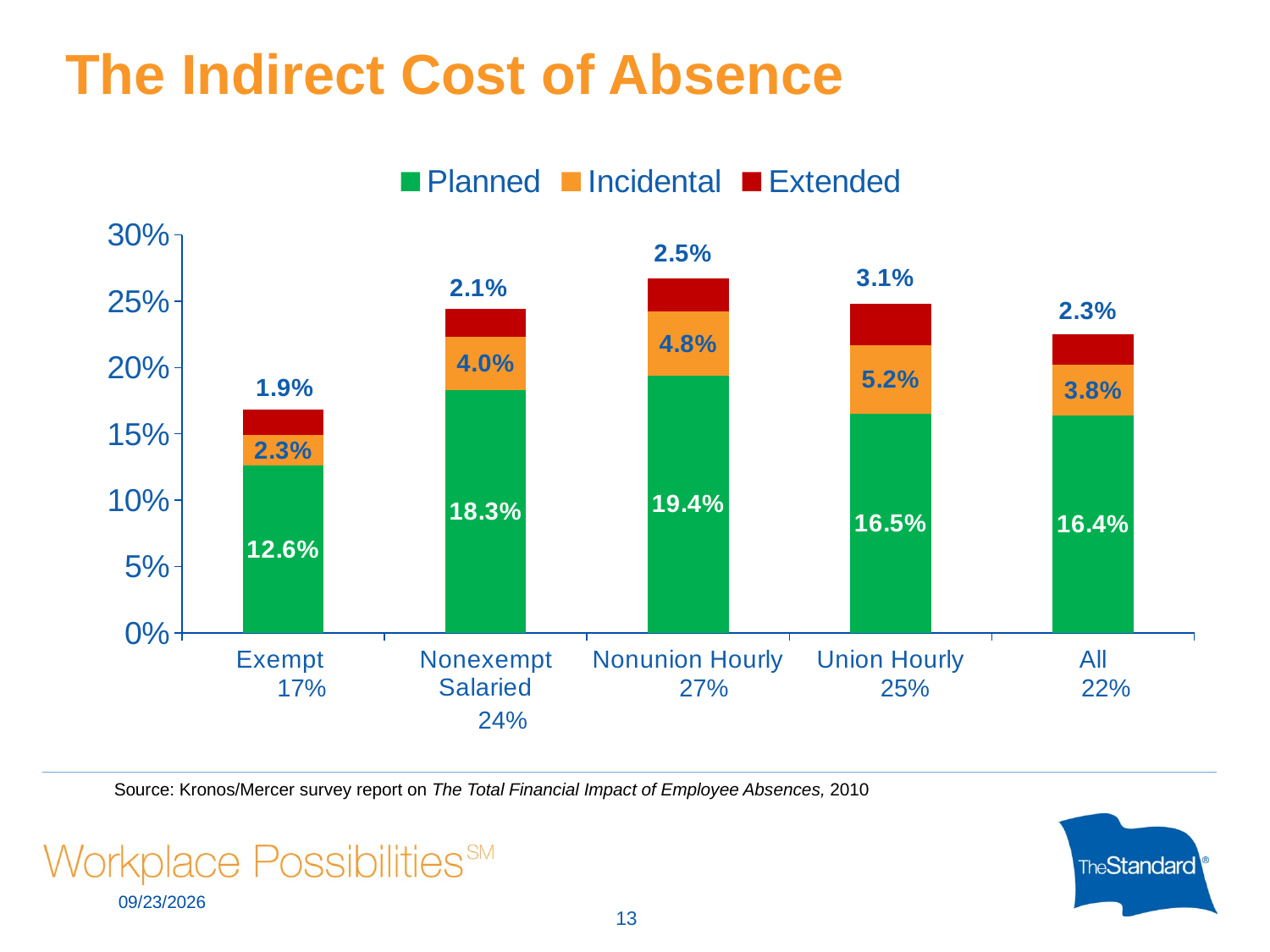
What is the Planned value for the All category? 16.4% Is the total stacked bar for Exempt greater or less than 20%? less What is the Extended value for Exempt? 1.9% How many series does the legend list? 3 Which category has the highest Planned value? Nonunion Hourly Which is larger, the Extended value for Union Hourly or the Extended value for Nonunion Hourly? Union Hourly Which category has the lowest Incidental value? Exempt What is the Planned value for Nonunion Hourly? 19.4% What is the Incidental value for Union Hourly? 5.2% How many categories are shown on the x axis? 5 What total percentage is printed under the Nonunion Hourly category label? 27% What is the difference between the Planned values for Nonexempt Salaried and Exempt? 5.7%